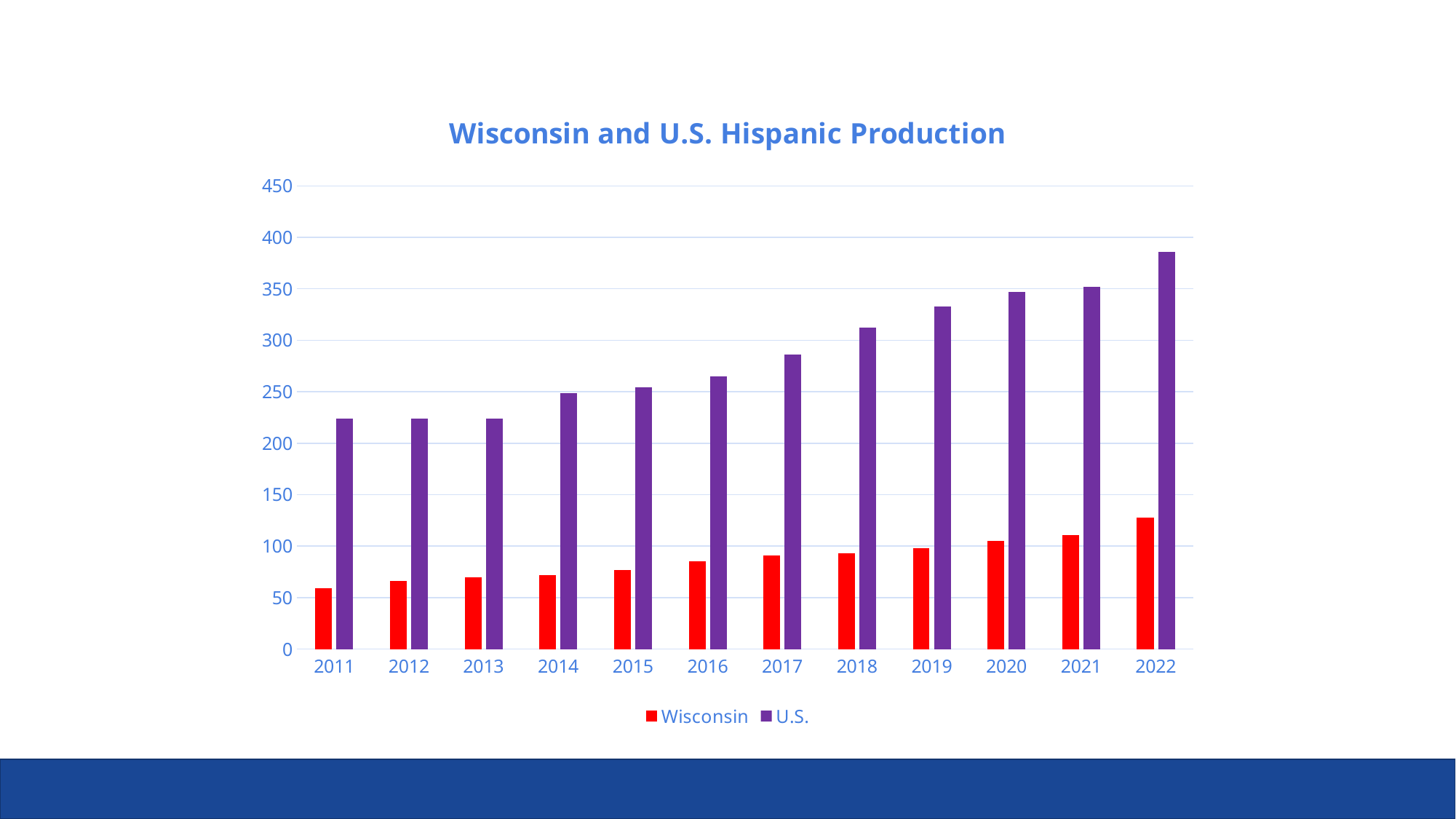
How many series does the legend list? 2 What type of chart is shown on the slide? bar chart Is the Wisconsin value for 2015 greater or less than 100? less Is the Wisconsin value for 2022 greater or less than 100? greater Which is larger in 2018, the Wisconsin value or the U.S. value? U.S. Do the U.S. values generally rise or fall from 2011 to 2022? rise Is the U.S. value for 2011 greater or less than 200? greater What is the title of the chart? Wisconsin and U.S. Hispanic Production Which year has the highest Wisconsin value? 2022 How many years are shown on the x axis? 12 Which year has the highest U.S. value? 2022